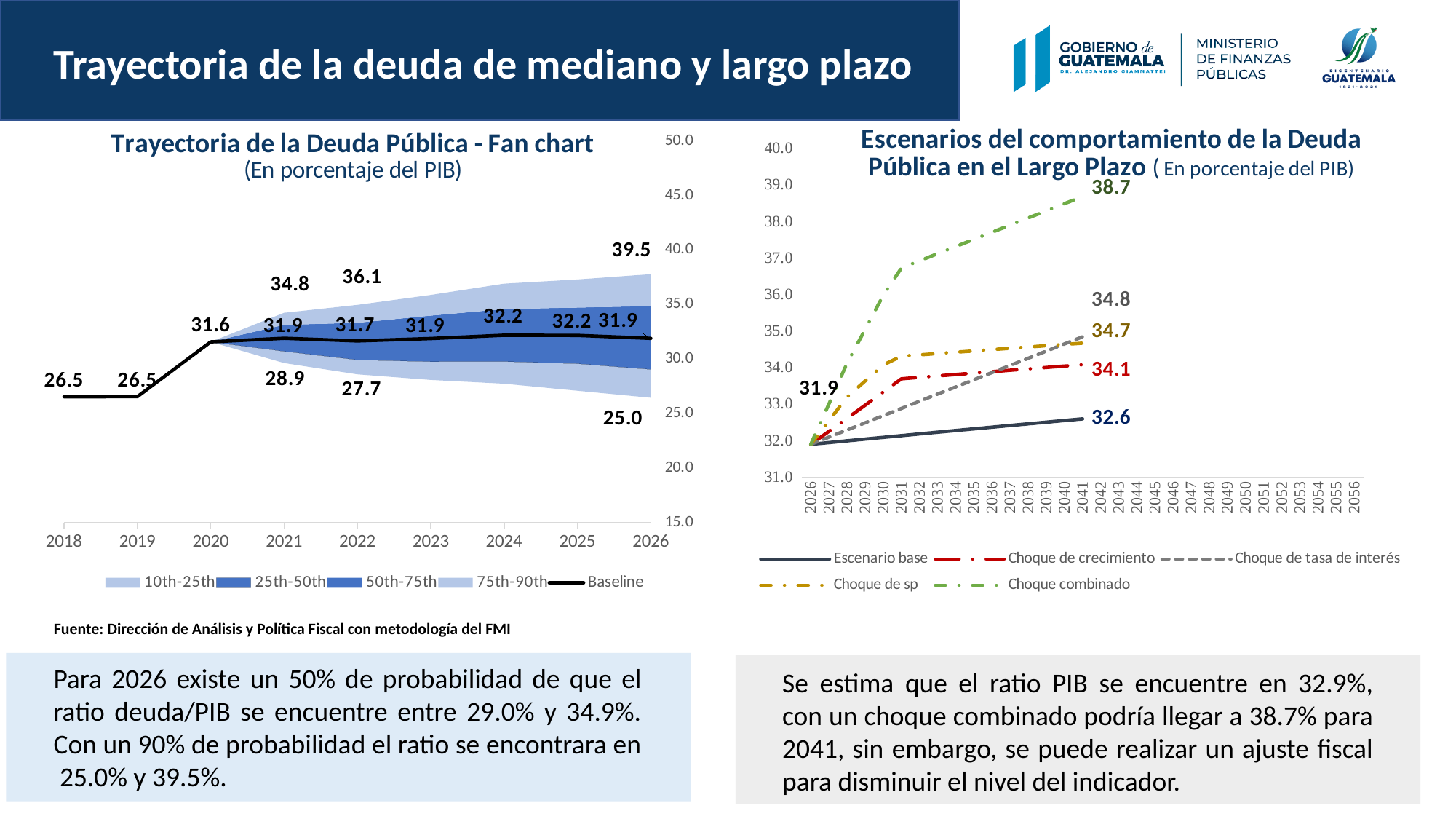
In the 'Trayectoria de la Deuda Pública - Fan chart', which Baseline value is larger, 2022 or 2024? 2024 In the 'Escenarios del comportamiento de la Deuda Pública en el Largo Plazo' chart, which scenario has the lowest value in 2041? Escenario base In the 'Trayectoria de la Deuda Pública - Fan chart', what is the difference between the upper (39.5) and lower (25.0) values labelled for 2026? 14.5 In the 'Trayectoria de la Deuda Pública - Fan chart', what is the Baseline value for 2018? 26.5 What kind of chart is the 'Escenarios del comportamiento de la Deuda Pública en el Largo Plazo' chart? Line chart In the 'Trayectoria de la Deuda Pública - Fan chart', how many entries does the legend list? 5 In the 'Trayectoria de la Deuda Pública - Fan chart', what is the Baseline value for 2020? 31.6 In the 'Escenarios del comportamiento de la Deuda Pública en el Largo Plazo' chart, what value does the Choque combinado series reach in 2041? 38.7 In the 'Escenarios del comportamiento de la Deuda Pública en el Largo Plazo' chart, what value does the Escenario base series reach in 2041? 32.6 In the 'Trayectoria de la Deuda Pública - Fan chart', how many years are shown on the x axis? 9 In the 'Trayectoria de la Deuda Pública - Fan chart', what is the upper value labelled for 2026? 39.5 In the 'Escenarios del comportamiento de la Deuda Pública en el Largo Plazo' chart, what is the difference between the Choque combinado and Escenario base values in 2041? 6.1